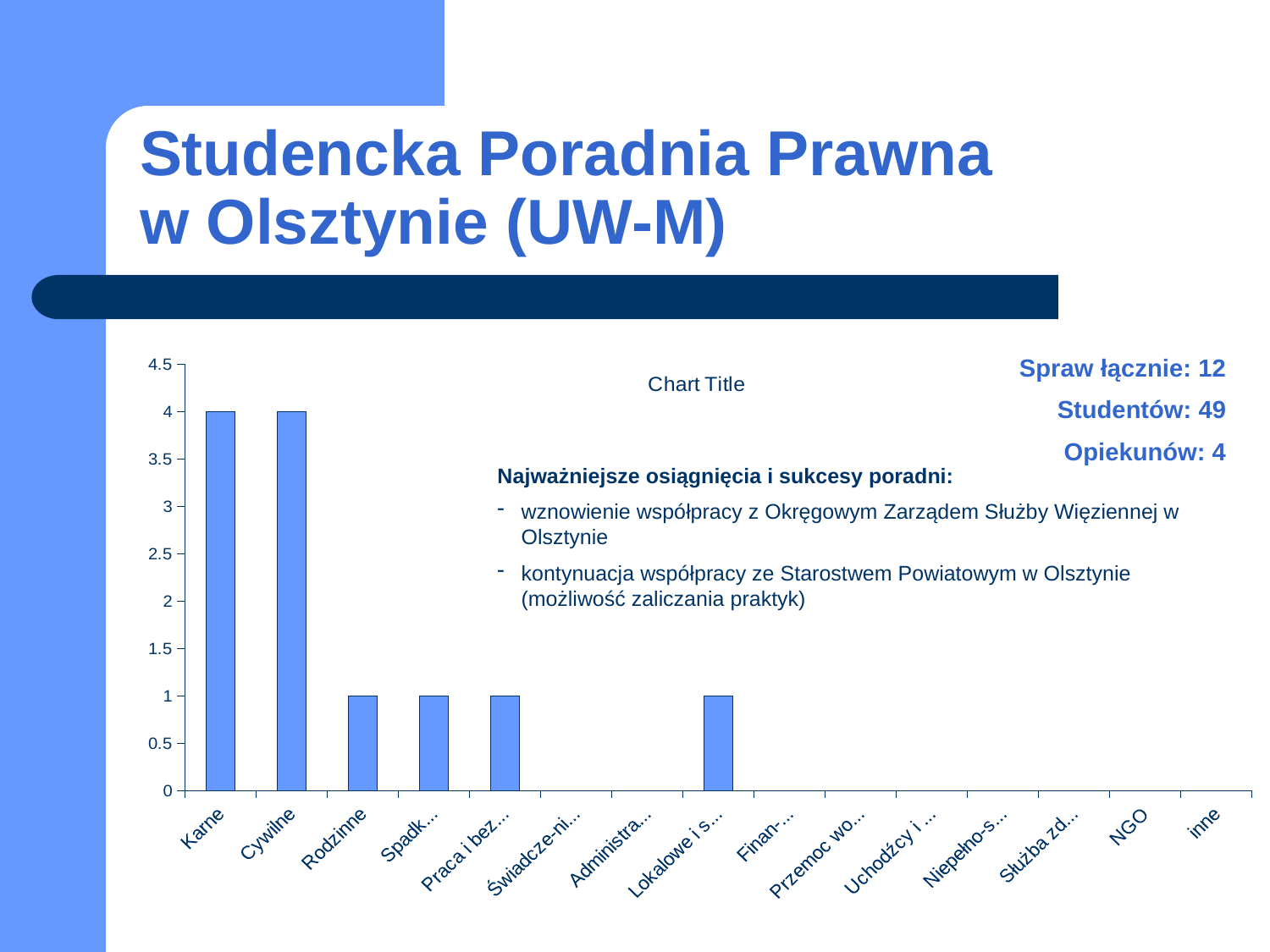
What is the value for NGO? 0 What is the title of the chart? Chart Title Which is larger, the value for Karne or the value for Rodzinne? Karne What is the value for Cywilne? 4 What is the value for Rodzinne? 1 How many categories have a value of 4? 2 What kind of chart is shown on the slide? bar chart How many categories are shown on the x axis of the chart? 15 What is the difference between the values for Karne and Rodzinne? 3 What is the value for Karne? 4 What is the value for inne? 0 Is the value for Karne greater or less than 3? greater